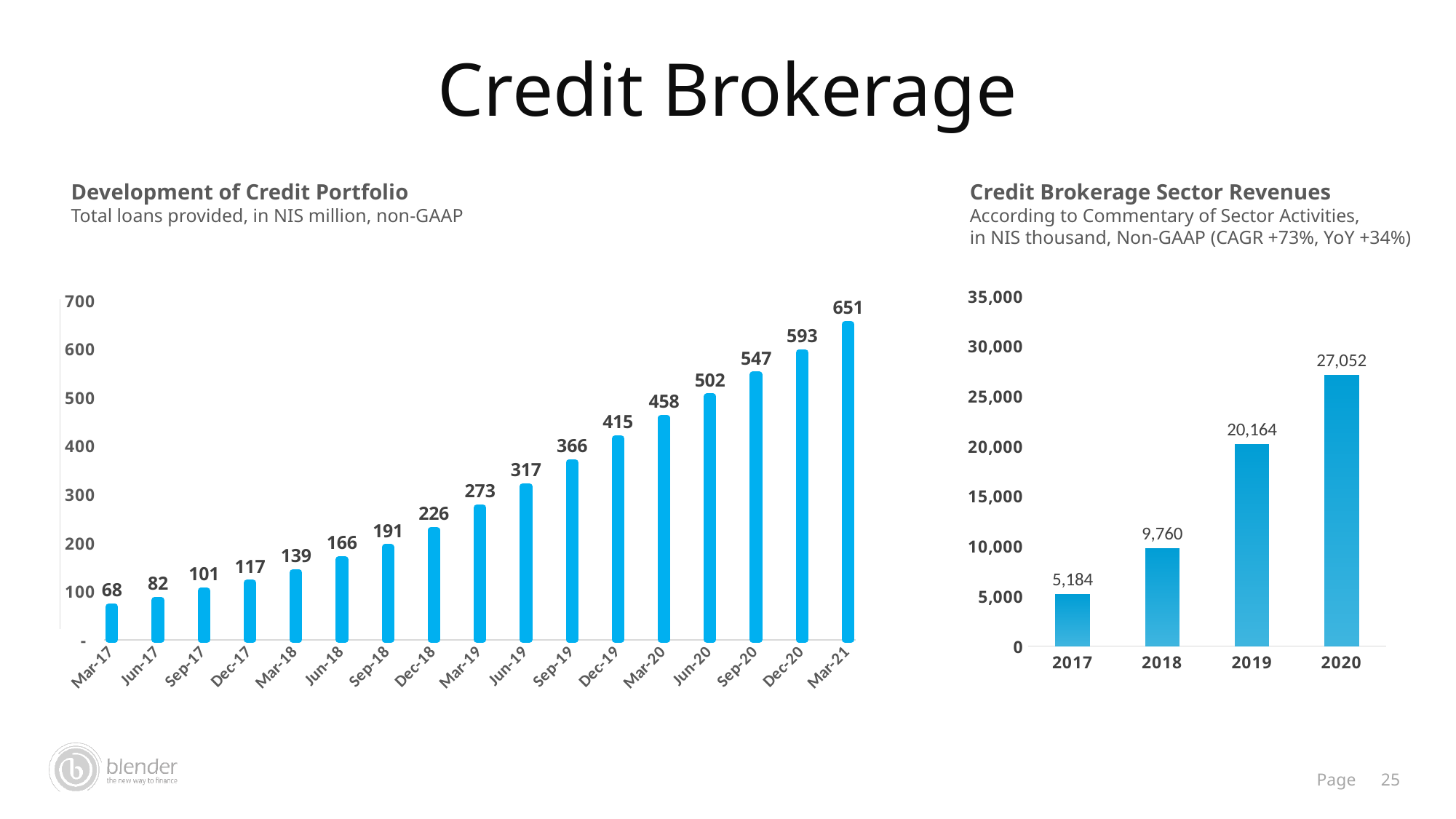
In the 'Development of Credit Portfolio' chart, what is the difference between the values for Dec-20 and Dec-19? 178 In the 'Credit Brokerage Sector Revenues' chart, how many years are shown? 4 In the 'Credit Brokerage Sector Revenues' chart, what is the difference between the values for 2020 and 2019? 6,888 In the 'Development of Credit Portfolio' chart, which is larger, the value for Jun-19 or the value for Sep-18? Jun-19 In the 'Credit Brokerage Sector Revenues' chart, what is the value for 2018? 9,760 In the 'Development of Credit Portfolio' chart, what is the value for Dec-18? 226 In the 'Development of Credit Portfolio' chart, which period has the lowest value? Mar-17 In the 'Development of Credit Portfolio' chart, what is the value for Mar-21? 651 In the 'Development of Credit Portfolio' chart, do the values rise or fall from Mar-17 to Mar-21? rise In the 'Development of Credit Portfolio' chart, how many periods are shown on the x axis? 17 In the 'Credit Brokerage Sector Revenues' chart, which year has the highest value? 2020 What kind of chart is the 'Credit Brokerage Sector Revenues' chart? bar chart